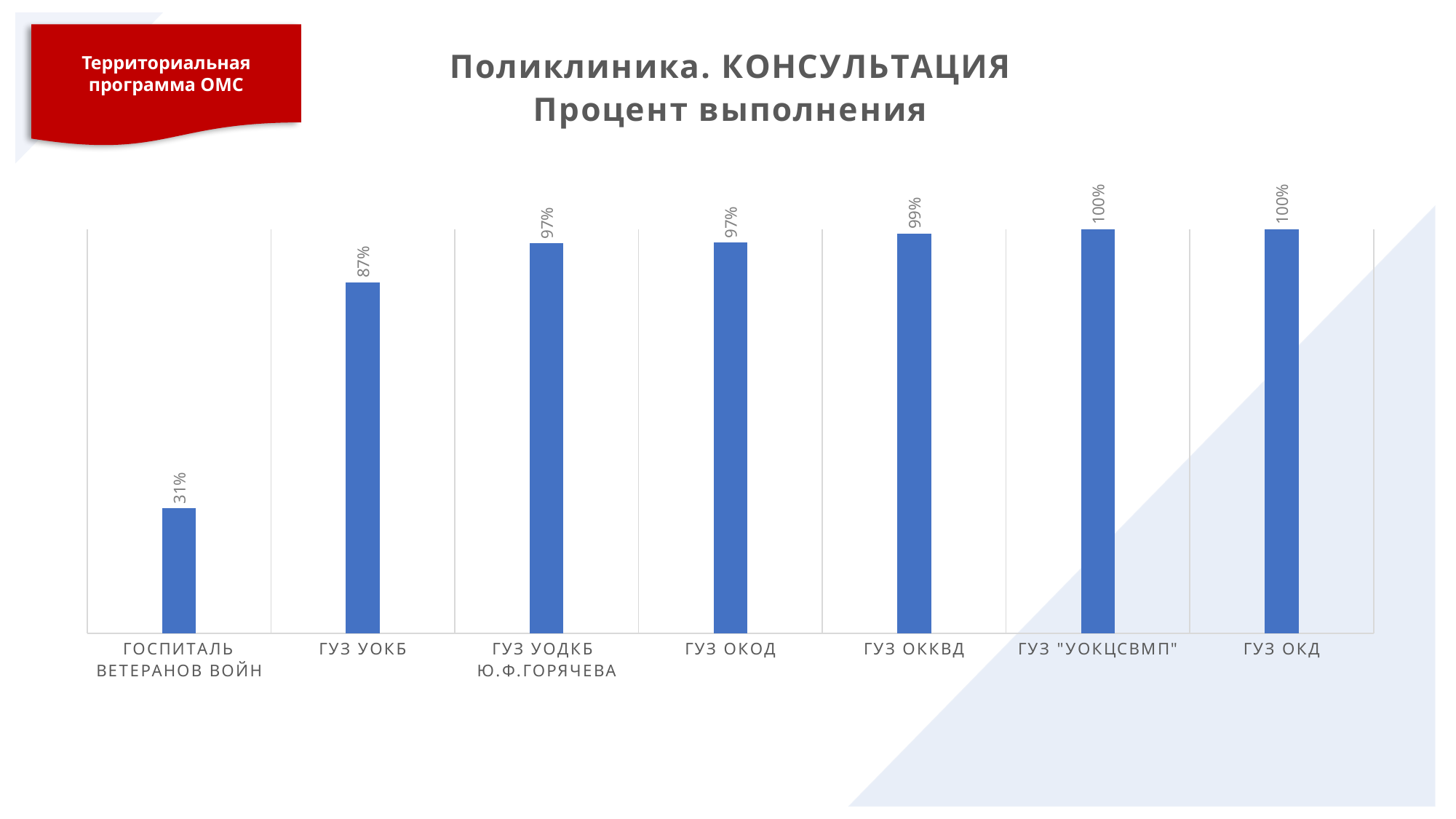
What is the value for ГОСПИТАЛЬ ВЕТЕРАНОВ ВОЙН? 31% How many categories are shown in the chart? 7 What is the value for ГУЗ ОККВД? 99% What is the difference between the values for ГУЗ УОКБ and ГОСПИТАЛЬ ВЕТЕРАНОВ ВОЙН? 56% What is the difference between the values for ГУЗ ОКД and ГУЗ ОККВД? 1% Which is larger, the value for ГУЗ УОКБ or the value for ГУЗ ОКОД? ГУЗ ОКОД What kind of chart is shown on the slide? Bar chart What is the value for ГУЗ УОКБ? 87% What is the value for ГУЗ ОКД? 100% What is the value for ГУЗ УОДКБ Ю.Ф.ГОРЯЧЕВА? 97% What is the title of the chart? Поликлиника. КОНСУЛЬТАЦИЯ Процент выполнения Which category has the lowest value? ГОСПИТАЛЬ ВЕТЕРАНОВ ВОЙН